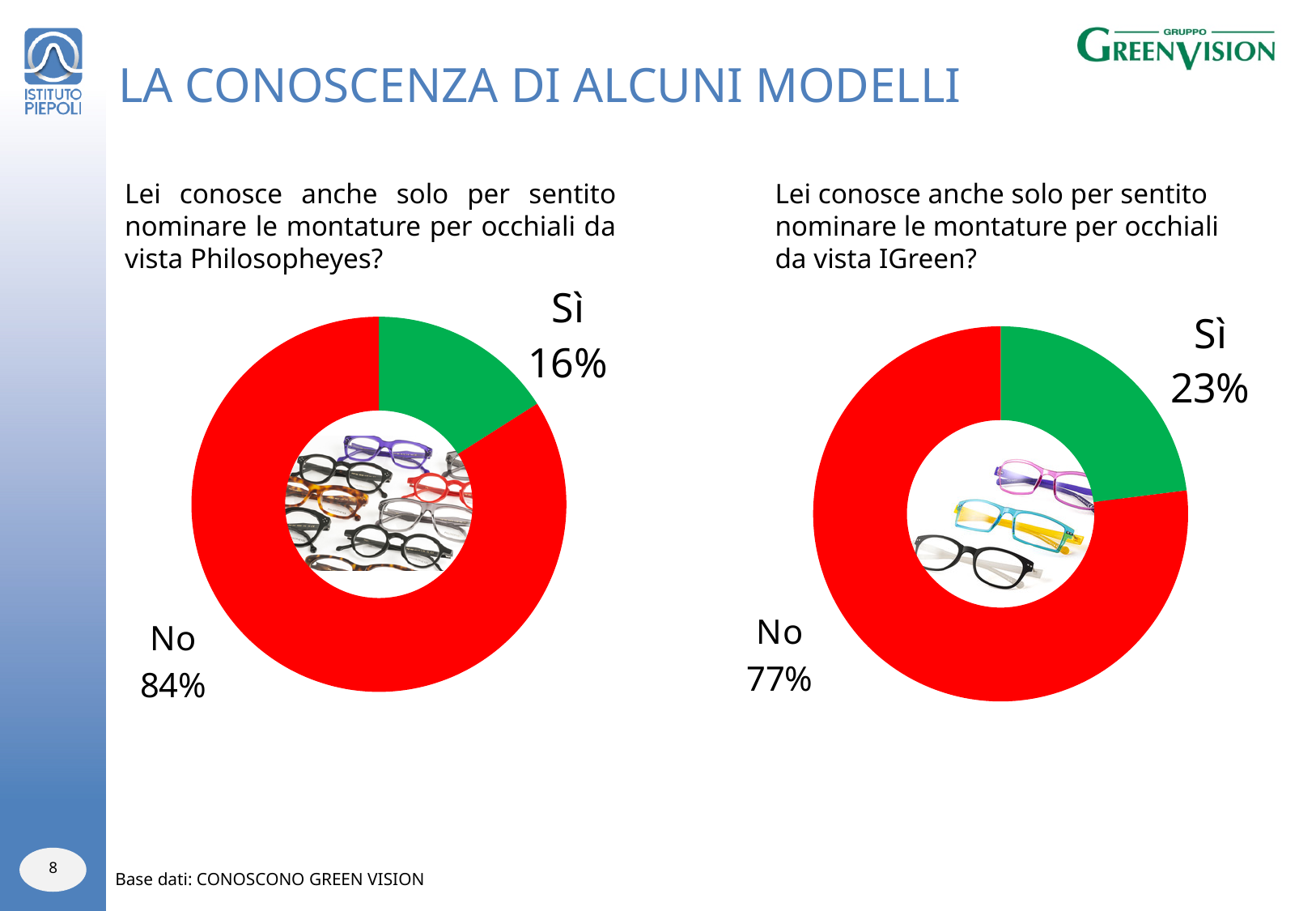
In the Philosopheyes chart on the left, what percentage answered Sì? 16% Which is larger: the Sì share in the Philosopheyes chart or the Sì share in the IGreen chart? IGreen In the IGreen chart on the right, what colour is the Sì slice? Green In the IGreen chart on the right, what percentage answered No? 77% In the IGreen chart on the right, what is the difference between the No and Sì shares? 54% In the Philosopheyes chart on the left, which answer has the largest share? No In the Philosopheyes chart on the left, what is the difference between the No and Sì shares? 68% In the Philosopheyes chart on the left, what percentage answered No? 84% What kind of chart is used for the IGreen question on the right? Doughnut (pie) chart In the IGreen chart on the right, what percentage answered Sì? 23% In the IGreen chart on the right, which answer has the smallest share? Sì How many slices does the Philosopheyes chart on the left have? 2